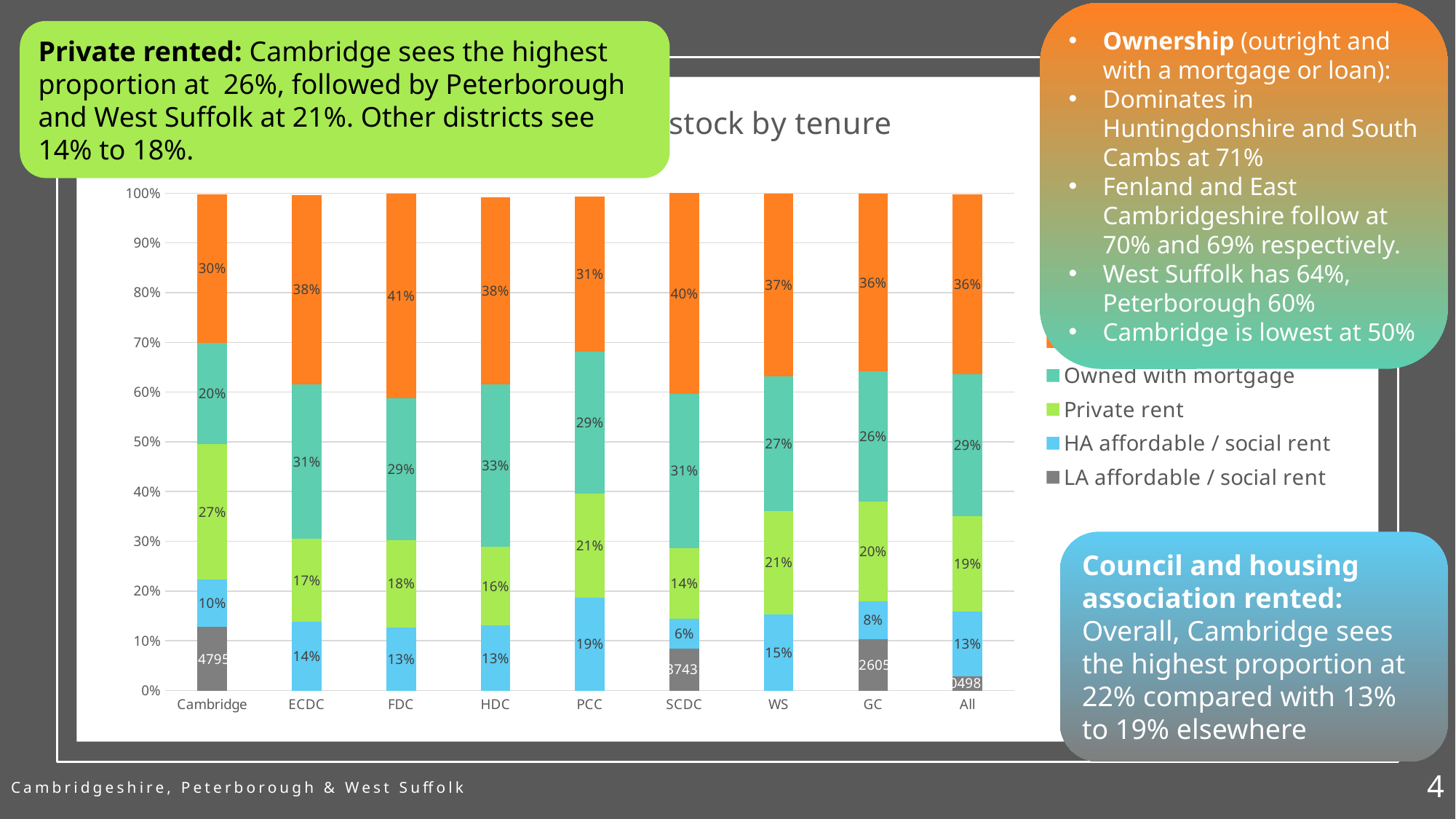
Which category has the highest Owned with mortgage percentage? HDC Which has a larger Owned with mortgage percentage, ECDC or WS? ECDC What is the Private rent percentage for Cambridge? 27% What kind of chart is shown on the slide? Stacked bar chart How many districts/categories are shown along the x axis of the chart? 9 What colour represents the Private rent series in the chart? Green What is the difference in percentage points between the Private rent share for Cambridge and for SCDC? 13 percentage points Which category has the highest Private rent percentage? Cambridge What is the Private rent percentage for the All bar? 19% What is the Owned with mortgage percentage for HDC? 33% What is the HA affordable / social rent percentage for PCC? 19% Which category has the lowest HA affordable / social rent percentage? SCDC